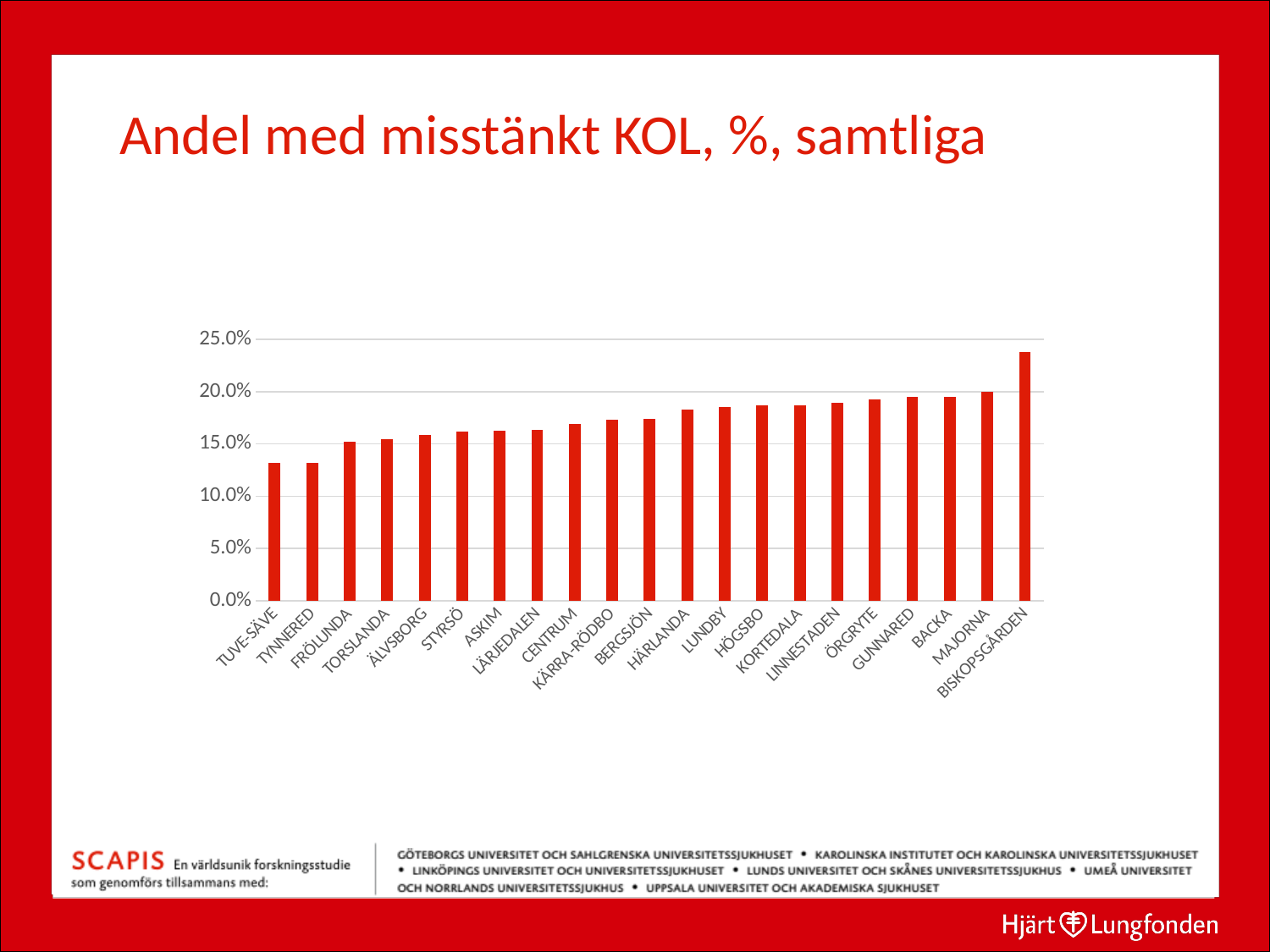
What is the title of the chart? Andel med misstänkt KOL, %, samtliga Which has a larger value, BISKOPSGÅRDEN or TUVE-SÄVE? BISKOPSGÅRDEN Which has a larger value, GUNNARED or ÄLVSBORG? GUNNARED Is the value for HÄRLANDA greater or less than 15.0%? greater Do the values generally rise or fall from left to right along the x axis? rise Which district has the highest value? BISKOPSGÅRDEN What colour are the bars in the chart? Red What kind of chart is shown on the slide? Bar chart How many categories (districts) are shown on the x axis? 21 Is the value for TUVE-SÄVE greater or less than 15.0%? less Is the value for BISKOPSGÅRDEN greater or less than 20.0%? greater